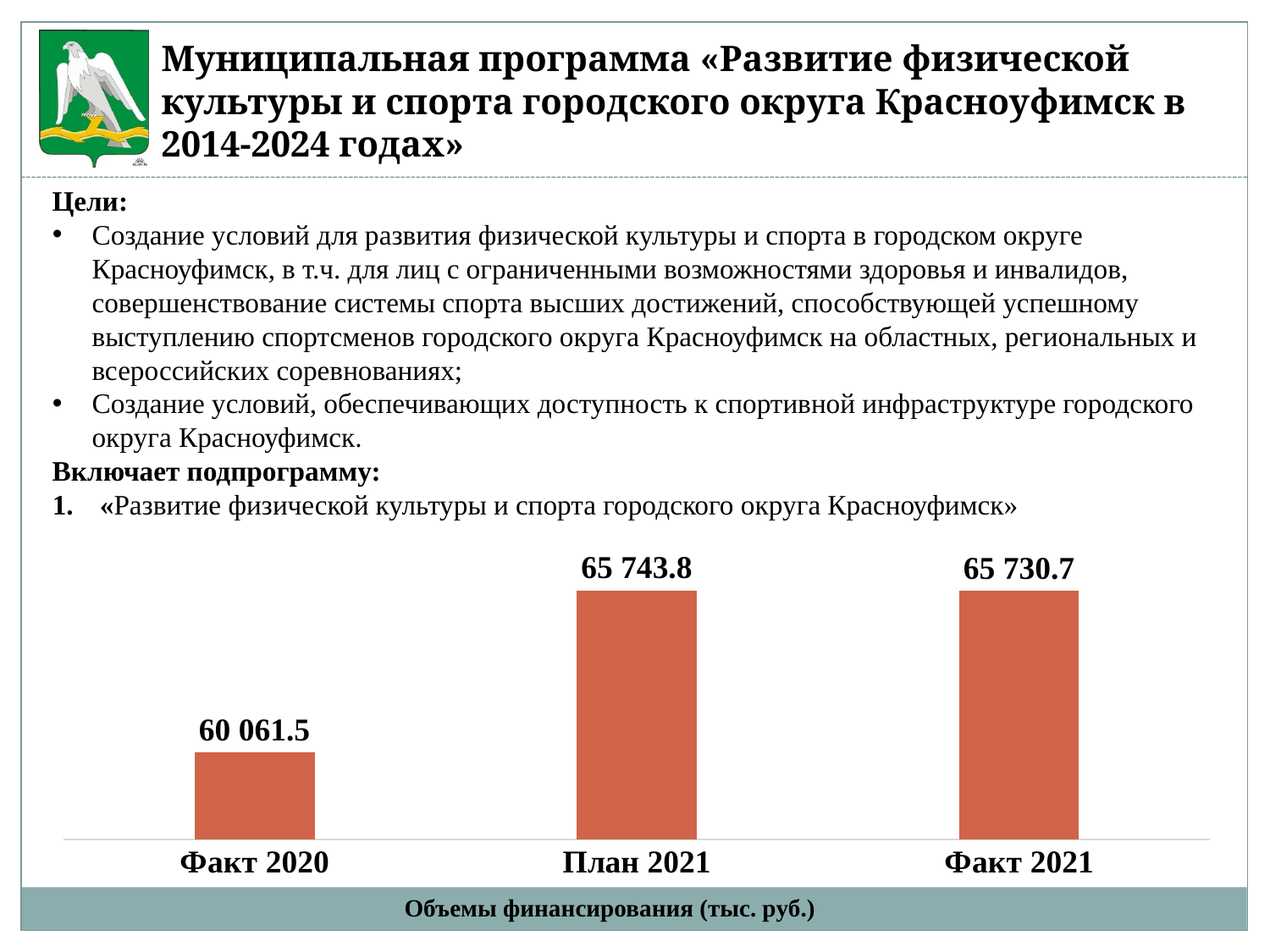
What is the value for План 2021 in the chart? 65 743.8 Which category has the highest value in the chart? План 2021 In what units are the financing volumes in the chart expressed, according to the caption below it? тыс. руб. What is the value for Факт 2021 in the chart? 65 730.7 How many categories are shown in the chart? 3 What is the difference between the values for План 2021 and Факт 2021? 13.1 What is the value for Факт 2020 in the chart? 60 061.5 Which is larger, the value for Факт 2021 or the value for Факт 2020? Факт 2021 What is the difference between the values for Факт 2021 and Факт 2020? 5 669.2 Which category has the lowest value in the chart? Факт 2020 What kind of chart is shown on the slide? Bar chart What is the difference between the values for План 2021 and Факт 2020? 5 682.3